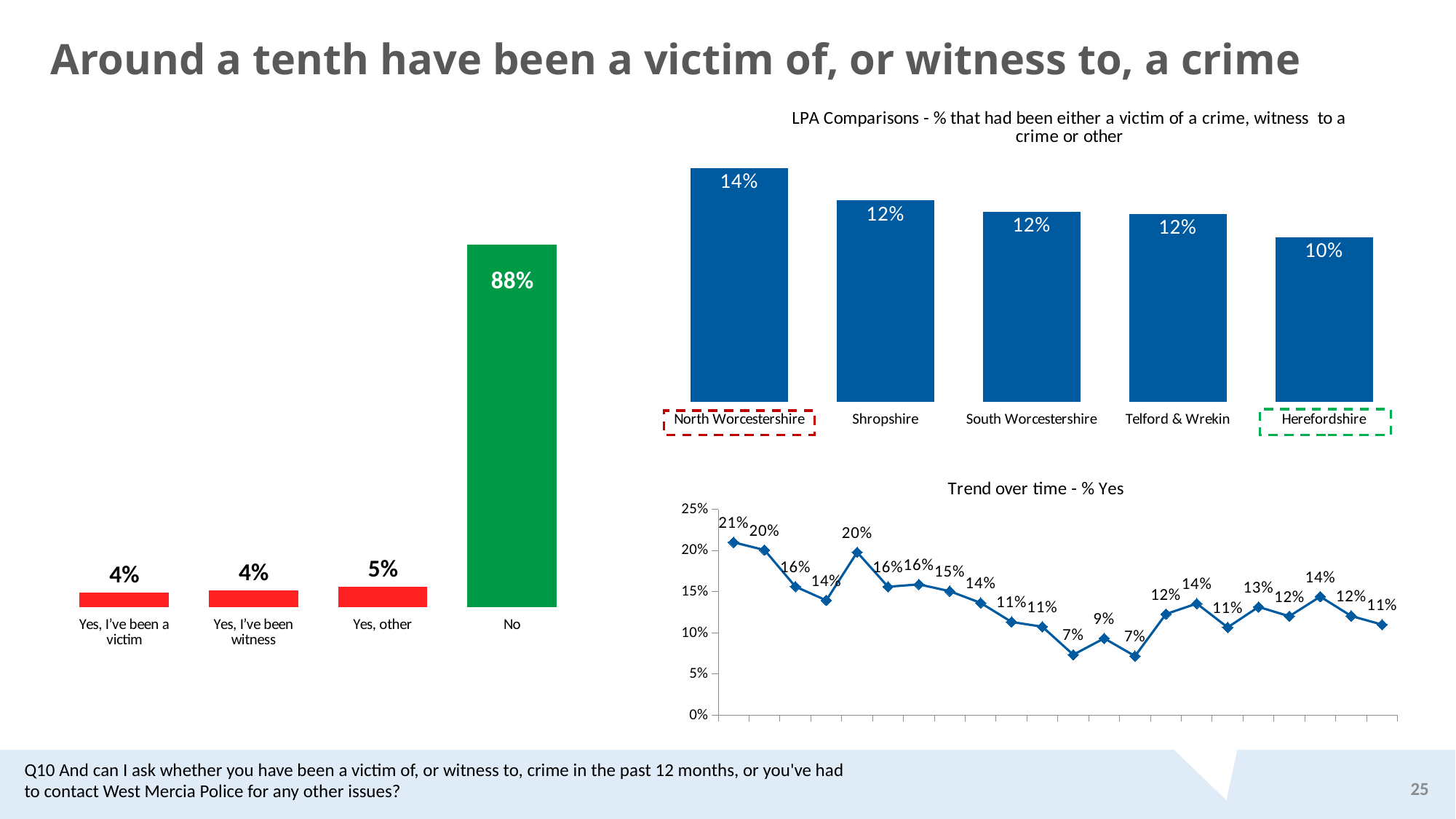
In the left-hand bar chart, what is the difference between the "No" value and the "Yes, other" value? 83% In the LPA Comparisons chart, what is the value for Shropshire? 12% In the LPA Comparisons chart, what is the difference between North Worcestershire and Herefordshire? 4% In the left-hand bar chart, what percentage of respondents answered "No"? 88% In the LPA Comparisons chart, which area has the lowest value? Herefordshire In the left-hand bar chart, how many categories are shown? 4 In the left-hand bar chart, what is the value for "Yes, other"? 5% What type of chart is the "Trend over time - % Yes" chart? Line chart In the "Trend over time - % Yes" chart, what is the value of the first data point? 21% In the LPA Comparisons chart, how many areas are compared? 5 In the LPA Comparisons chart, which area has the highest value? North Worcestershire In the "Trend over time - % Yes" chart, what is the lowest value plotted? 7%